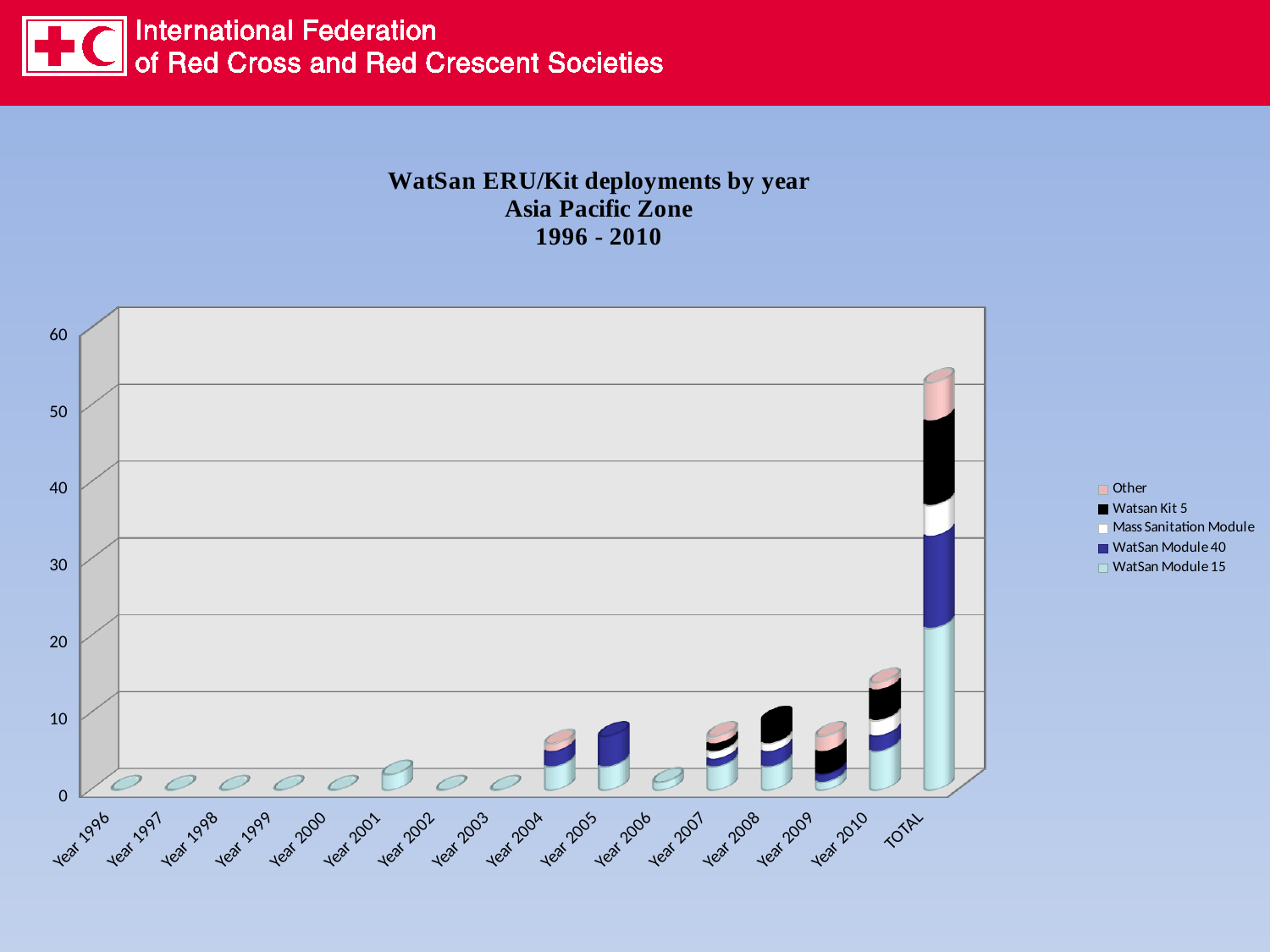
Which has the larger total, Year 2005 or Year 2006? Year 2005 Is the total value for Year 2010 greater or less than 10? greater What is the title of the chart? WatSan ERU/Kit deployments by year Asia Pacific Zone 1996 - 2010 Which series is shown in black in the legend? Watsan Kit 5 Is the total value for Year 2005 greater or less than 10? less Is the total value for TOTAL greater or less than 50? greater Which has the larger total, Year 2010 or Year 2004? Year 2010 How many series does the legend list? 5 What kind of chart is shown on the slide? Stacked bar chart Which category has the tallest bar? TOTAL How many categories are shown along the x axis? 16